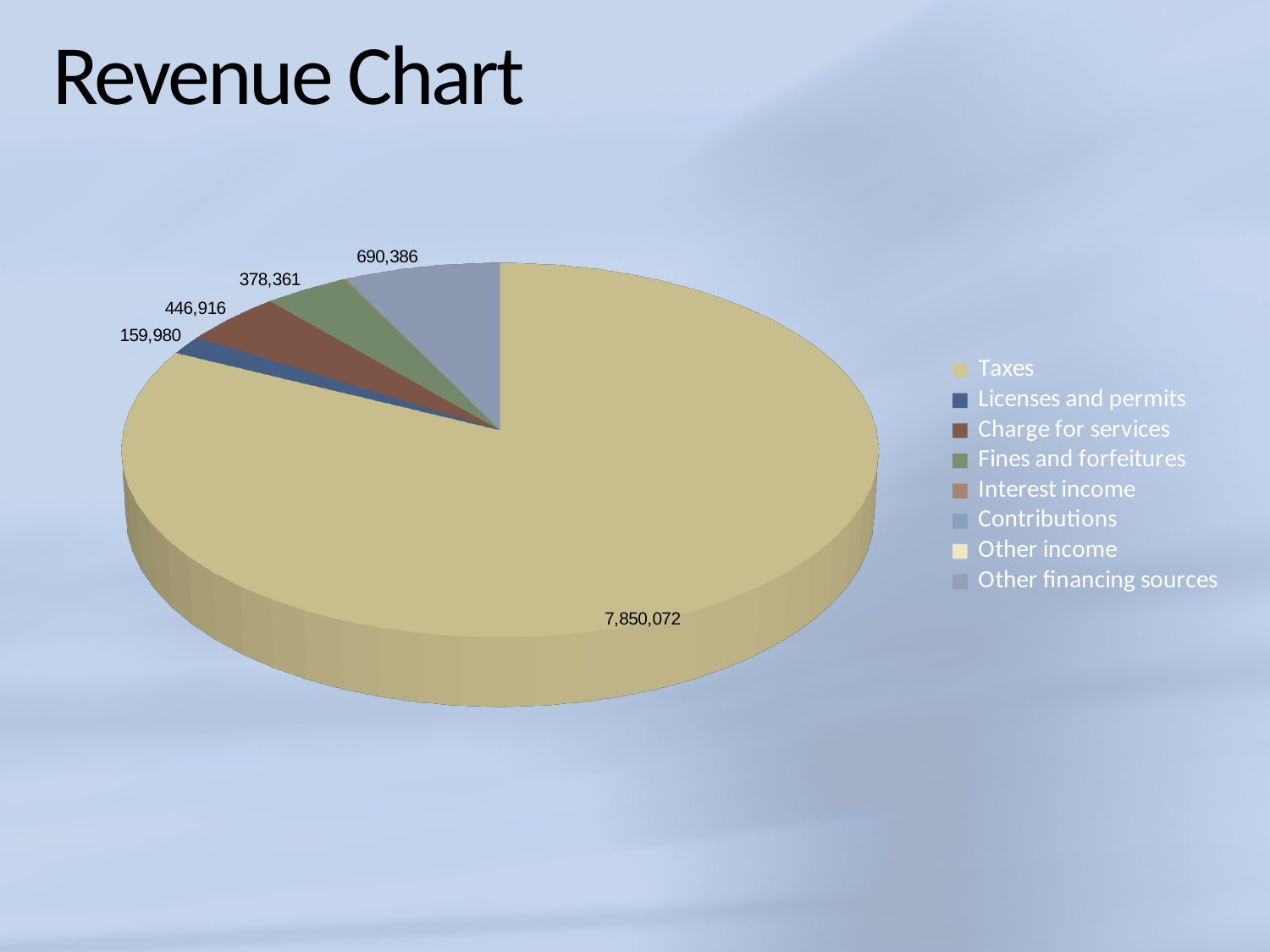
How many data labels are printed on the pie? 5 What kind of chart is shown on the slide? pie chart How many entries does the legend list? 8 What is the value shown for Fines and forfeitures? 378,361 Which is larger, Charge for services or Fines and forfeitures? Charge for services What is the value shown for Licenses and permits? 159,980 What is the title of the slide? Revenue Chart What is the difference between Charge for services and Fines and forfeitures? 68,555 What is the value shown for Charge for services? 446,916 Which category has the largest slice of the pie? Taxes What is the value shown for Taxes? 7,850,072 What is the value of the second-largest slice in the pie? 690,386